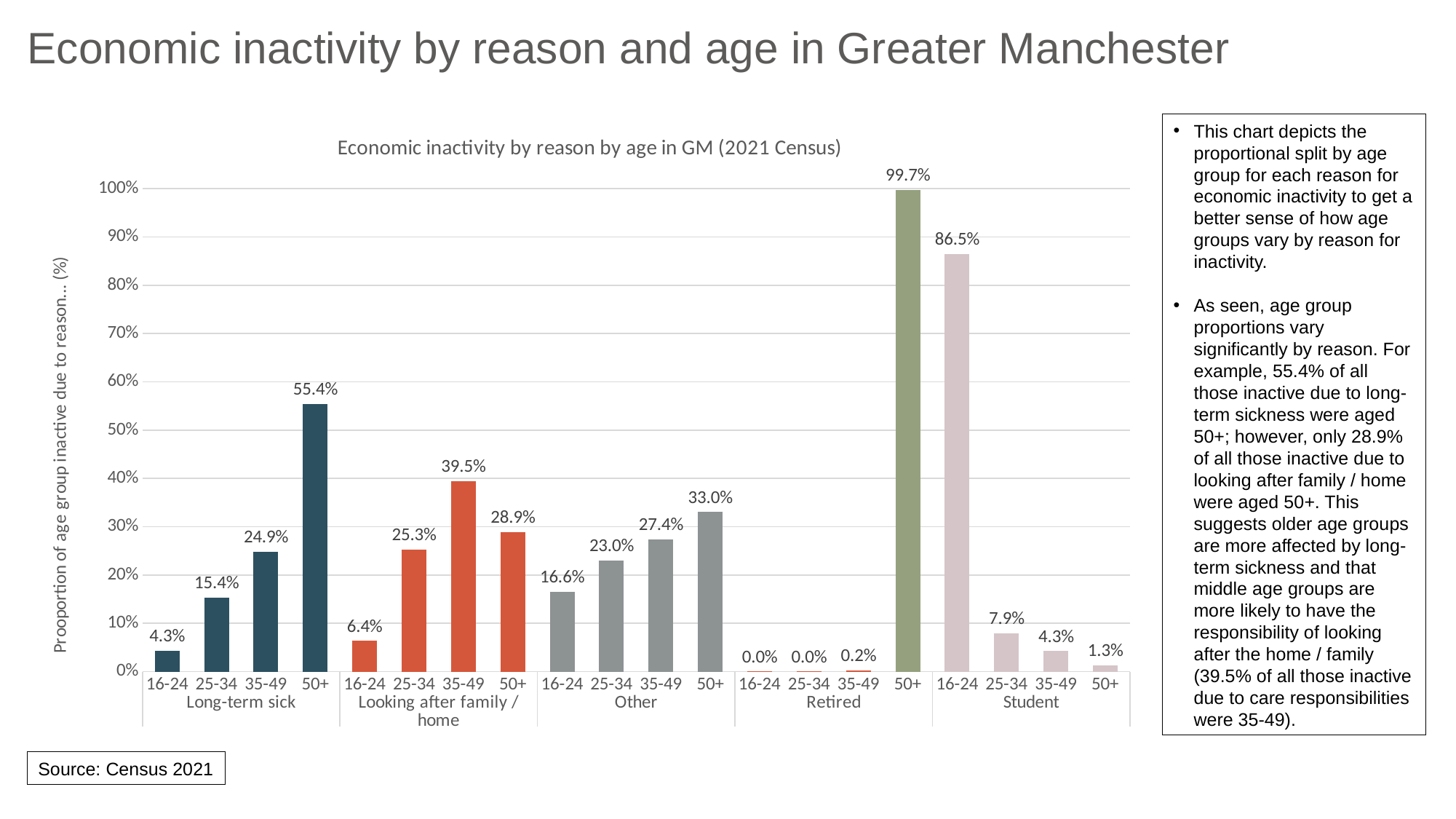
How many reason categories are shown on the x axis? 5 Which is larger: the 25-34 value for Long-term sick or the 25-34 value for Other? Other (23.0%) What proportion of those inactive due to long-term sickness were aged 50+? 55.4% Within the Other category, which age group has the lowest proportion? 16-24 What proportion of those inactive due to looking after family / home were aged 35-49? 39.5% What is the title of the chart? Economic inactivity by reason by age in GM (2021 Census) Is the value for the 50+ age group in the Other category greater or less than 30%? greater What is the value for the 35-49 age group in the Retired category? 0.2% What proportion of students (economically inactive) were aged 16-24? 86.5% Which bar on the chart has the highest value? Retired, 50+ (99.7%) What is the difference between the 50+ proportion for Long-term sick and the 50+ proportion for Looking after family / home? 26.5 percentage points What type of chart is shown on the slide? Bar chart